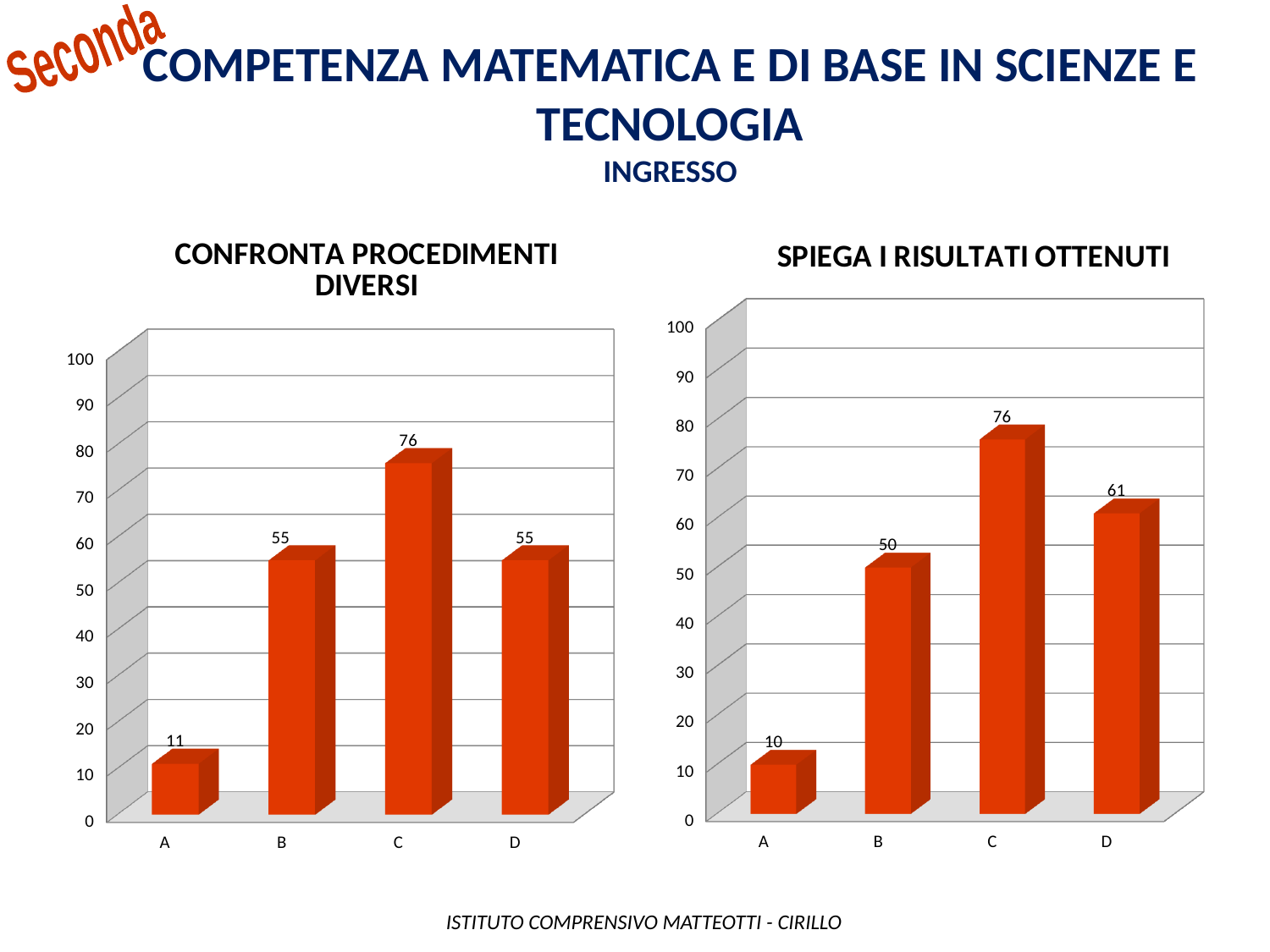
In the 'SPIEGA I RISULTATI OTTENUTI' chart, what is the difference between the values for C and B? 26 In the 'SPIEGA I RISULTATI OTTENUTI' chart, which category has the highest value? C In the 'SPIEGA I RISULTATI OTTENUTI' chart, what is the value for category D? 61 In the 'CONFRONTA PROCEDIMENTI DIVERSI' chart, which category has the lowest value? A In the 'CONFRONTA PROCEDIMENTI DIVERSI' chart, what is the difference between the values for B and A? 44 What type of chart is the 'CONFRONTA PROCEDIMENTI DIVERSI' chart? Bar chart How many categories are shown in the 'SPIEGA I RISULTATI OTTENUTI' chart? 4 In the 'CONFRONTA PROCEDIMENTI DIVERSI' chart, what is the value for category C? 76 In the 'CONFRONTA PROCEDIMENTI DIVERSI' chart, is the value for D greater or less than 50? greater In the 'SPIEGA I RISULTATI OTTENUTI' chart, which is larger, the value for B or the value for D? D In the 'CONFRONTA PROCEDIMENTI DIVERSI' chart, what is the value for category A? 11 How many charts are shown on the slide? 2